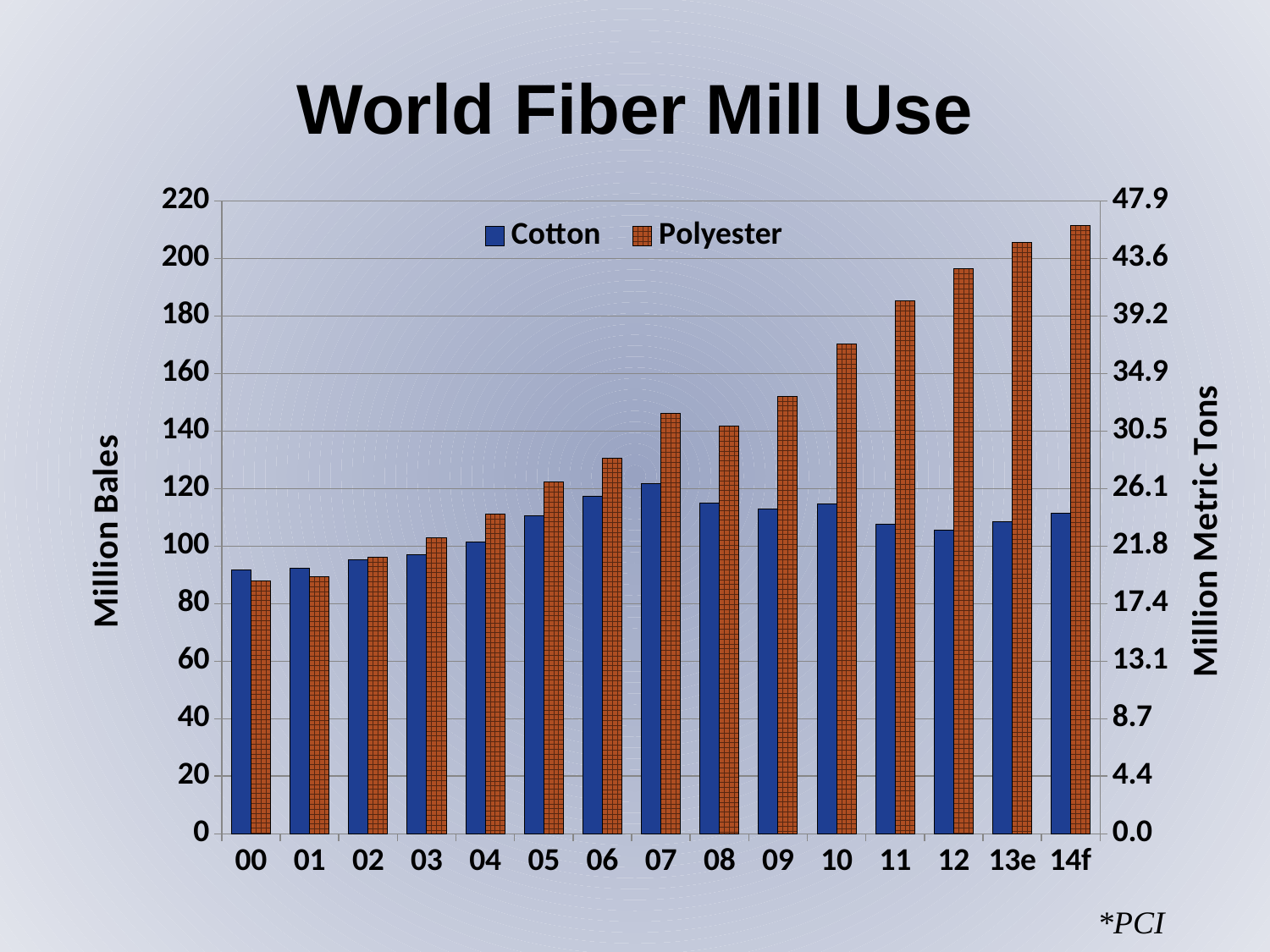
What kind of chart is shown on the slide? bar chart Is the Polyester value for 10 greater or less than 34.9 million metric tons? greater What is the label of the left vertical axis? Million Bales How many series does the legend list? 2 In which year is the Polyester bar the highest? 14f Which is larger, the Cotton value for 06 or the Cotton value for 11? 06 Is the Polyester value for 14f greater or less than 43.6 million metric tons? greater How many years (categories) are shown on the x axis? 15 What is the title of the chart? World Fiber Mill Use Does the Polyester series generally rise or fall from 00 to 14f? rise In which year is the Cotton bar the highest? 07 Is the Cotton value for 00 greater or less than 100 million bales? less